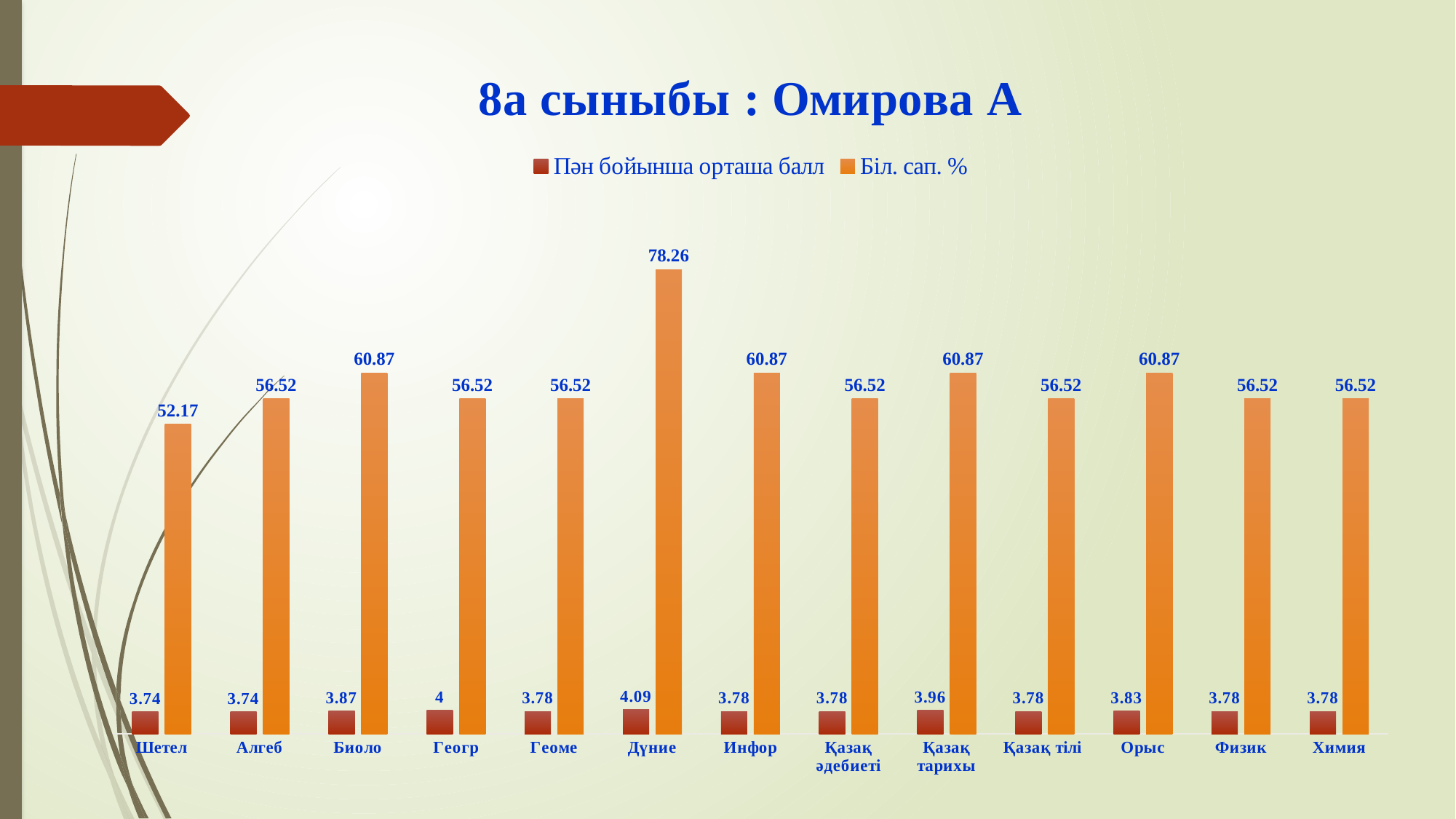
Which category has the highest Пән бойынша орташа балл value? Дүние Which is larger, the Біл. сап. % value for Орыс or for Физик? Орыс Which category has the lowest Біл. сап. % value? Шетел What is the value of Біл. сап. % for Шетел? 52.17 What is the difference between the Біл. сап. % values for Дүние and Биоло? 17.39 Which category has the highest Біл. сап. % value? Дүние What type of chart is shown on the slide? Bar chart What is the value of Пән бойынша орташа балл for Геогр? 4 How many categories are shown on the x axis? 13 How many series does the legend list? 2 What is the value of Пән бойынша орташа балл for Қазақ тарихы? 3.96 What is the value of Біл. сап. % for Дүние? 78.26